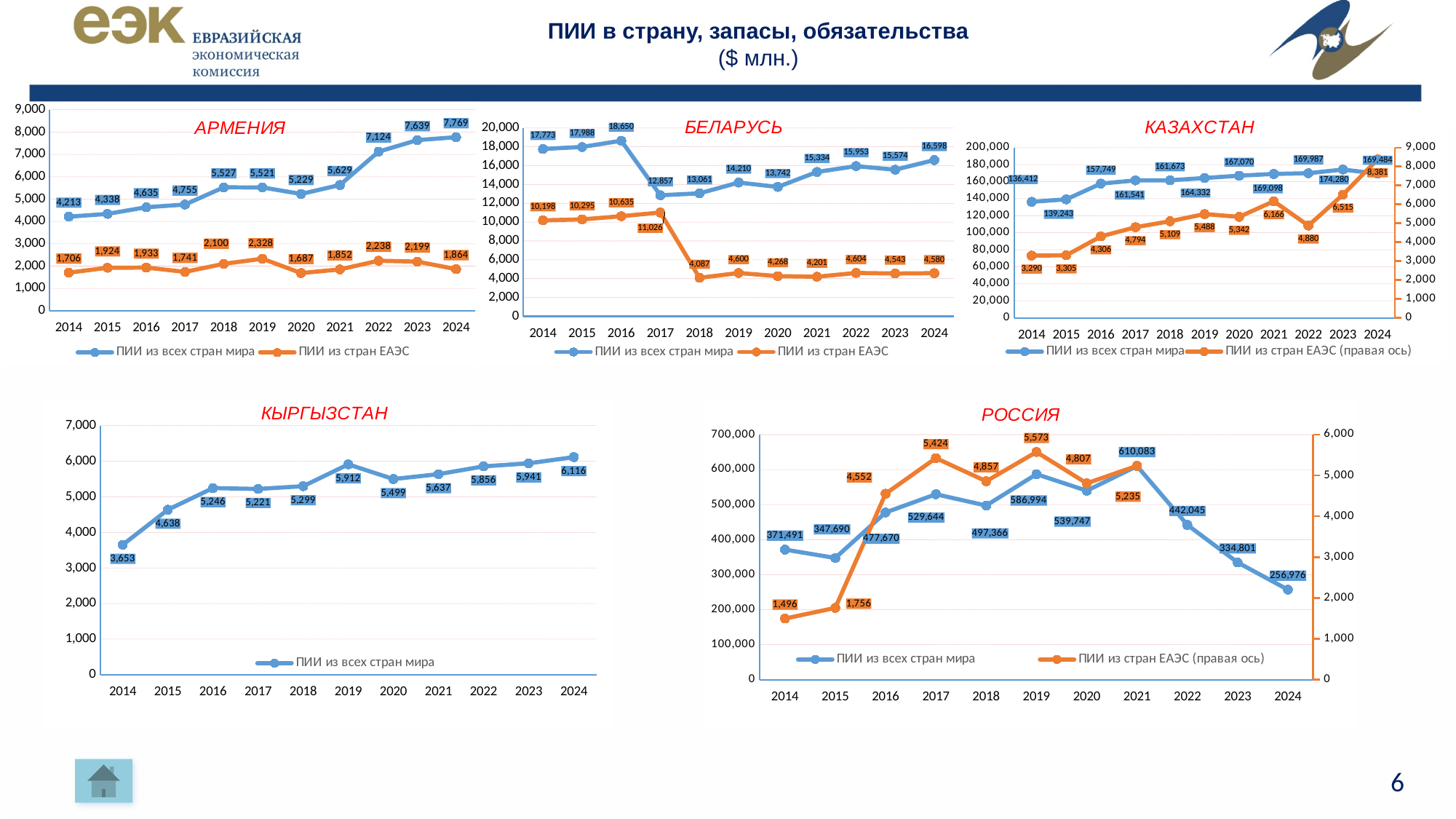
On the КЫРГЫЗСТАН chart, how many years are plotted on the x axis? 11 What kind of chart is the КЫРГЫЗСТАН chart? line chart On the КАЗАХСТАН chart, in which year is ПИИ из всех стран мира highest? 2023 On the КАЗАХСТАН chart, what is the value of ПИИ из стран ЕАЭС (правая ось) in 2024? 8,381 On the РОССИЯ chart, in which year is ПИИ из всех стран мира highest? 2021 On the АРМЕНИЯ chart, what is the value of ПИИ из всех стран мира in 2024? 7,769 On the БЕЛАРУСЬ chart, what is the difference between ПИИ из всех стран мира in 2016 and in 2017? 5,793 On the РОССИЯ chart, does ПИИ из всех стран мира rise or fall from 2021 to 2024? fall On the БЕЛАРУСЬ chart, in which year is ПИИ из всех стран мира lowest? 2017 On the РОССИЯ chart, which year has the larger value of ПИИ из всех стран мира, 2014 or 2015? 2014 On the АРМЕНИЯ chart, in which year is ПИИ из стран ЕАЭС highest? 2019 On the КЫРГЫЗСТАН chart, how many series does the legend list? 1